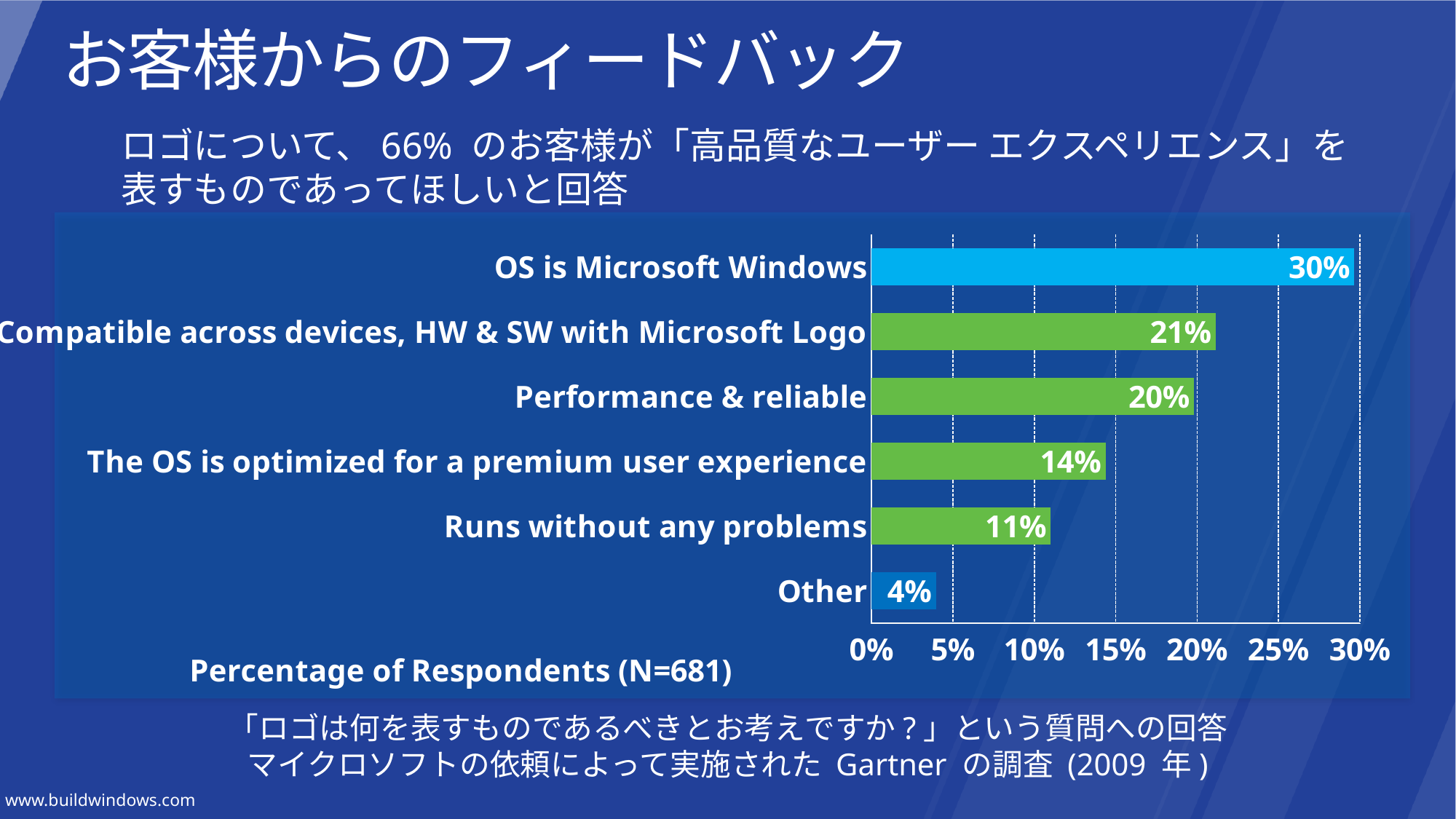
Which category has the lowest value? Other What is the value for "Other"? 4% What kind of chart is shown on the slide? Bar chart What is the value for "OS is Microsoft Windows"? 30% What is the difference between "The OS is optimized for a premium user experience" and "Runs without any problems"? 3% What is the value for "Performance & reliable"? 20% What is the value for "Runs without any problems"? 11% What is the label of the horizontal axis of the chart? Percentage of Respondents (N=681) What is the difference between "OS is Microsoft Windows" and "Compatible across devices, HW & SW with Microsoft Logo"? 9% How many categories are shown in the chart? 6 Which category has the highest value? OS is Microsoft Windows Which is larger, "Performance & reliable" or "The OS is optimized for a premium user experience"? Performance & reliable